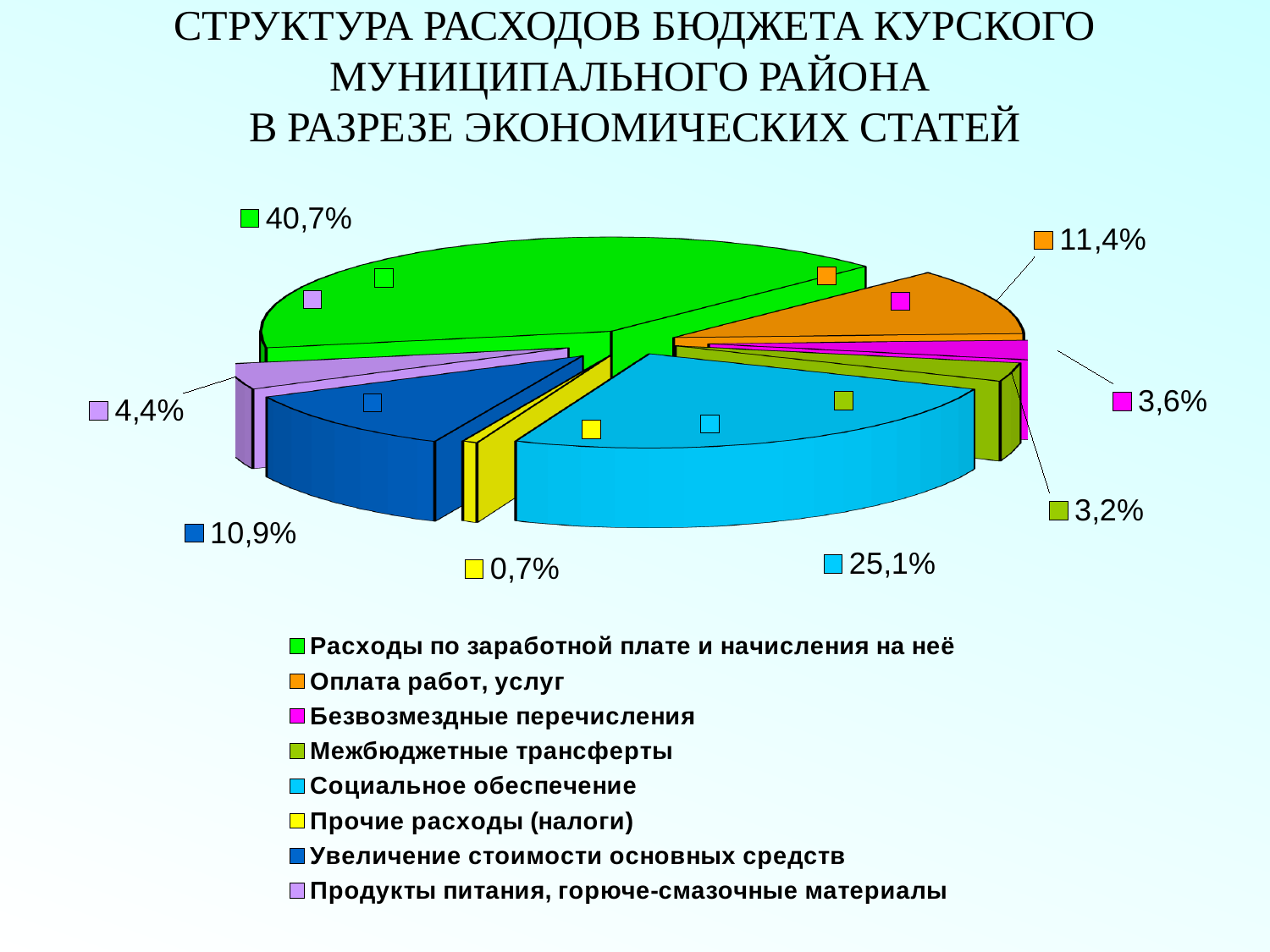
What colour is the slice for "Социальное обеспечение"? Light blue What is the difference in percentage points between "Расходы по заработной плате и начисления на неё" and "Социальное обеспечение"? 15,6 What percentage is shown for "Увеличение стоимости основных средств"? 10,9% What percentage is shown for "Оплата работ, услуг"? 11,4% How many categories does the pie chart show? 8 Which is larger: the share for "Продукты питания, горюче-смазочные материалы" or for "Безвозмездные перечисления"? Продукты питания, горюче-смазочные материалы What percentage is shown for "Межбюджетные трансферты"? 3,2% What percentage is shown for "Социальное обеспечение"? 25,1% What type of chart is shown on the slide? Pie chart What share of the budget expenses is "Расходы по заработной плате и начисления на неё"? 40,7% Which category has the largest share of the budget expenses? Расходы по заработной плате и начисления на неё Which category has the smallest share of the budget expenses? Прочие расходы (налоги)